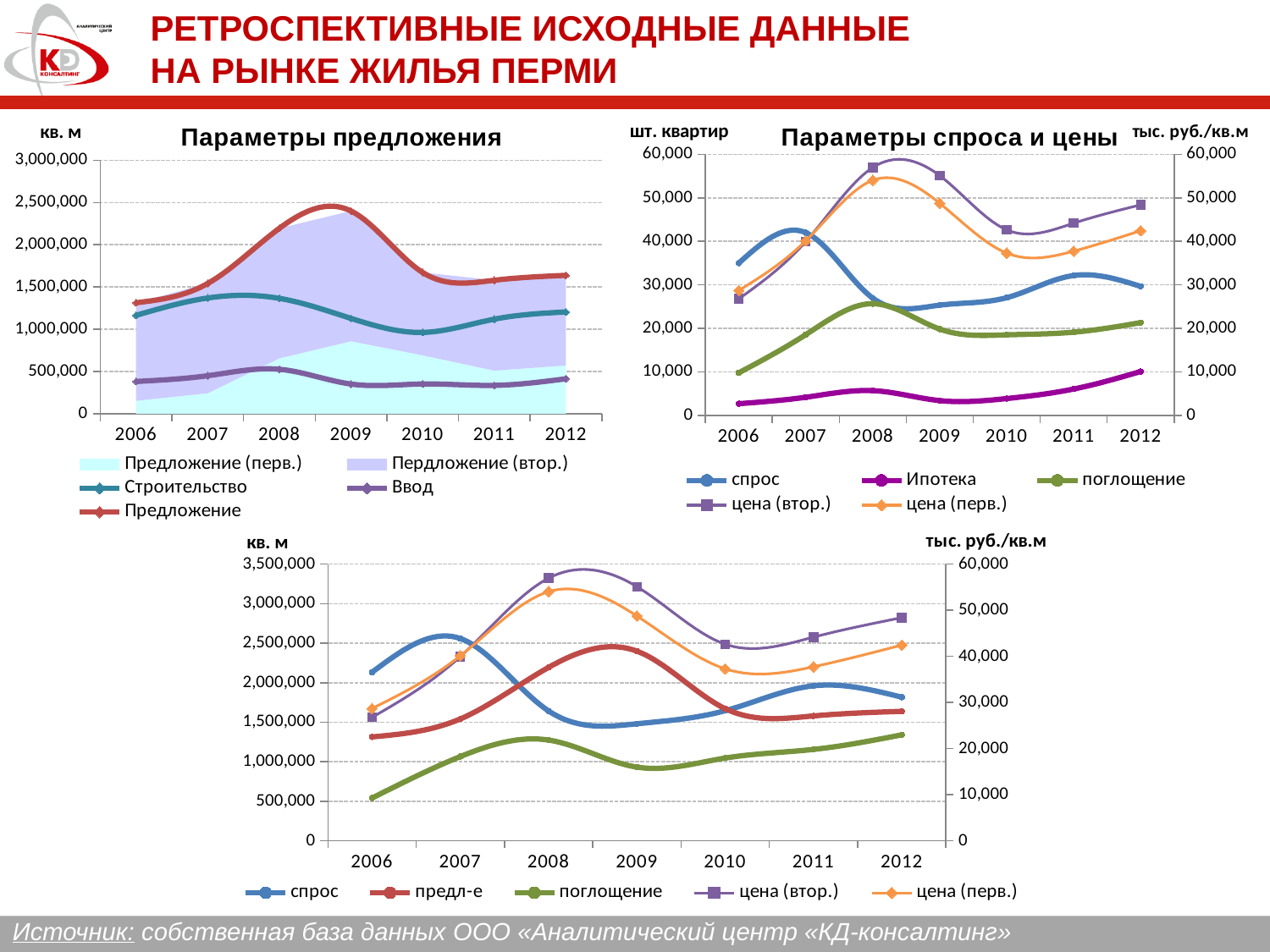
What kind of chart is the chart titled "Параметры спроса и цены"? line chart On the chart titled "Параметры спроса и цены", in which year is спрос highest? 2007 On the chart titled "Параметры спроса и цены", does Ипотека rise or fall from 2009 to 2012? rise On the chart titled "Параметры предложения", is the value for Ввод in 2010 greater or less than 500,000? less On the chart titled "Параметры предложения", is the value for Предложение in 2009 greater or less than 2,000,000? greater On the chart titled "Параметры предложения", how many years are shown on the x axis? 7 On the chart titled "Параметры спроса и цены", is the value for Ипотека in 2006 greater or less than 10,000? less On the chart titled "Параметры спроса и цены", which is higher in 2012: цена (втор.) or цена (перв.)? цена (втор.) On the chart titled "Параметры спроса и цены", what unit is shown on the right-hand axis? тыс. руб./кв.м On the chart titled "Параметры предложения", in which year is Предложение highest? 2009 On the chart titled "Параметры спроса и цены", how many series does the legend list? 5